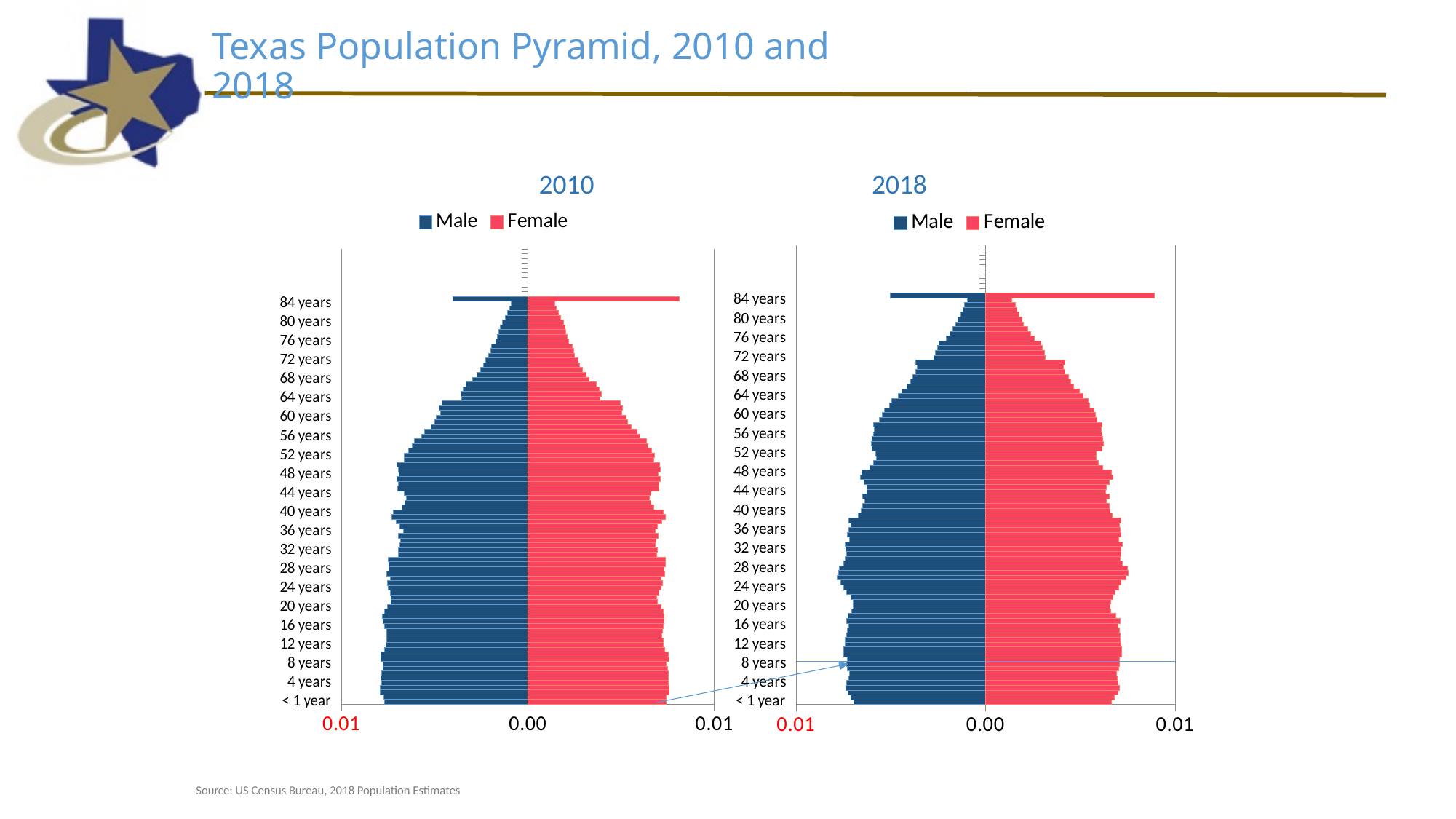
In the 2010 chart, do the Male values rise or fall as age increases from 40 years to 80 years? fall How many age-group labels are shown on the vertical axis of the 2010 chart? 22 In the 2010 chart, is the Female value for 84 years greater or less than 0.01? less In the 2018 chart, which is larger for Male, the value at 28 years or the value at 68 years? 28 years In the 2018 chart, which colour represents Female? Red What kind of chart is the 2010 chart? bar chart In the 2018 chart, is the Male value for 8 years greater or less than 0.01? less In the 2010 chart, which is larger for Female, the value at 40 years or the value at 76 years? 40 years In the 2018 chart, which is larger at 84 years, the Male value or the Female value? Female How many series does the legend of the 2018 chart list? 2 What are the two series named in the legend of the 2010 chart? Male and Female